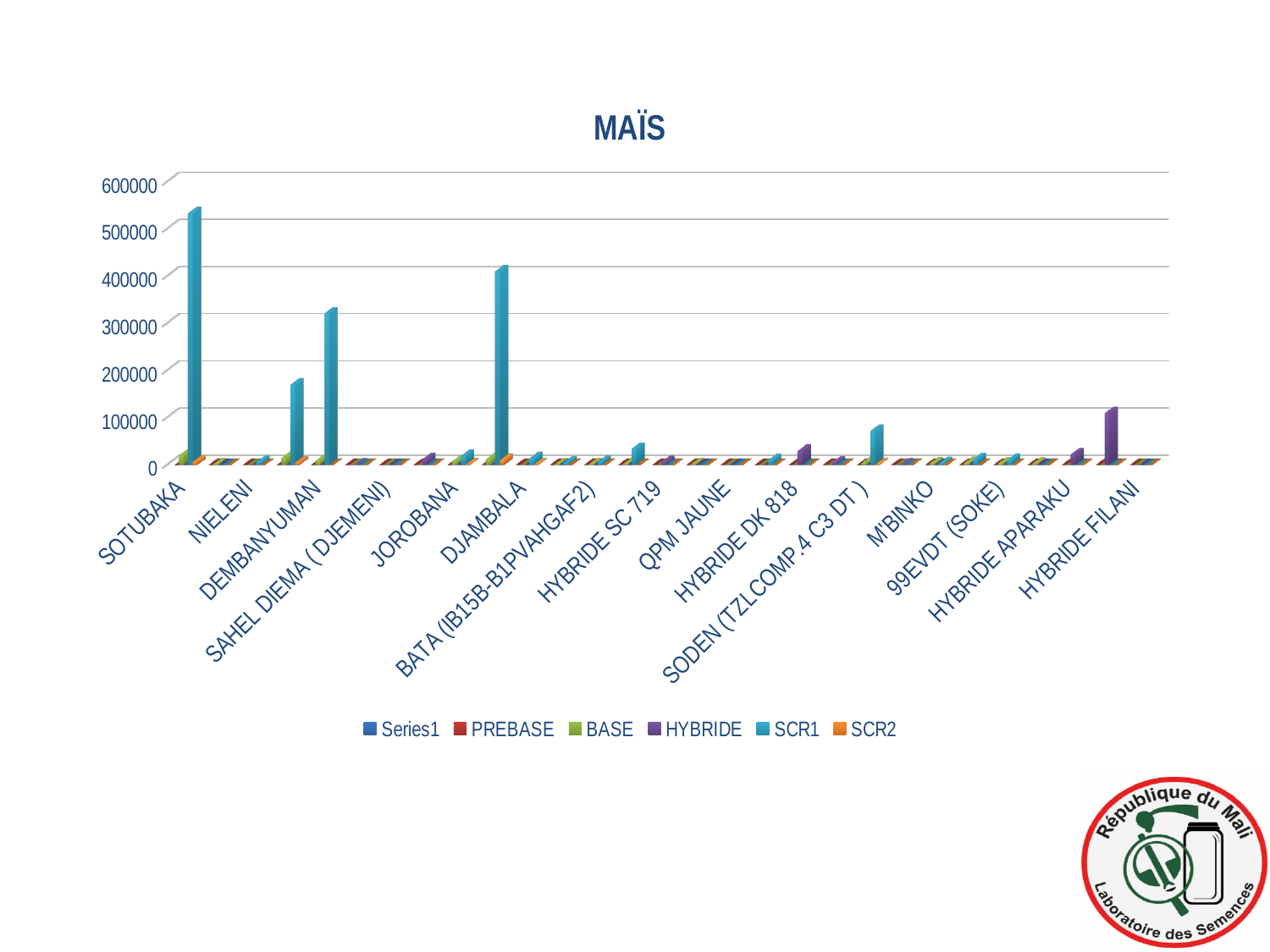
Is the HYBRIDE value for HYBRIDE FILANI greater or less than 200000? less What is the highest value shown on the vertical axis? 600000 What is the title of the chart? MAÏS Which is larger: the SCR1 value for SOTUBAKA or the HYBRIDE value for HYBRIDE FILANI? SCR1 value for SOTUBAKA Is the SCR1 value for SOTUBAKA greater or less than 500000? greater Which category is listed first on the x axis? SOTUBAKA What kind of chart is shown on the slide? Bar chart Which series is listed last in the legend? SCR2 Which category has the tallest bar in the chart? SOTUBAKA How many series does the legend list? 6